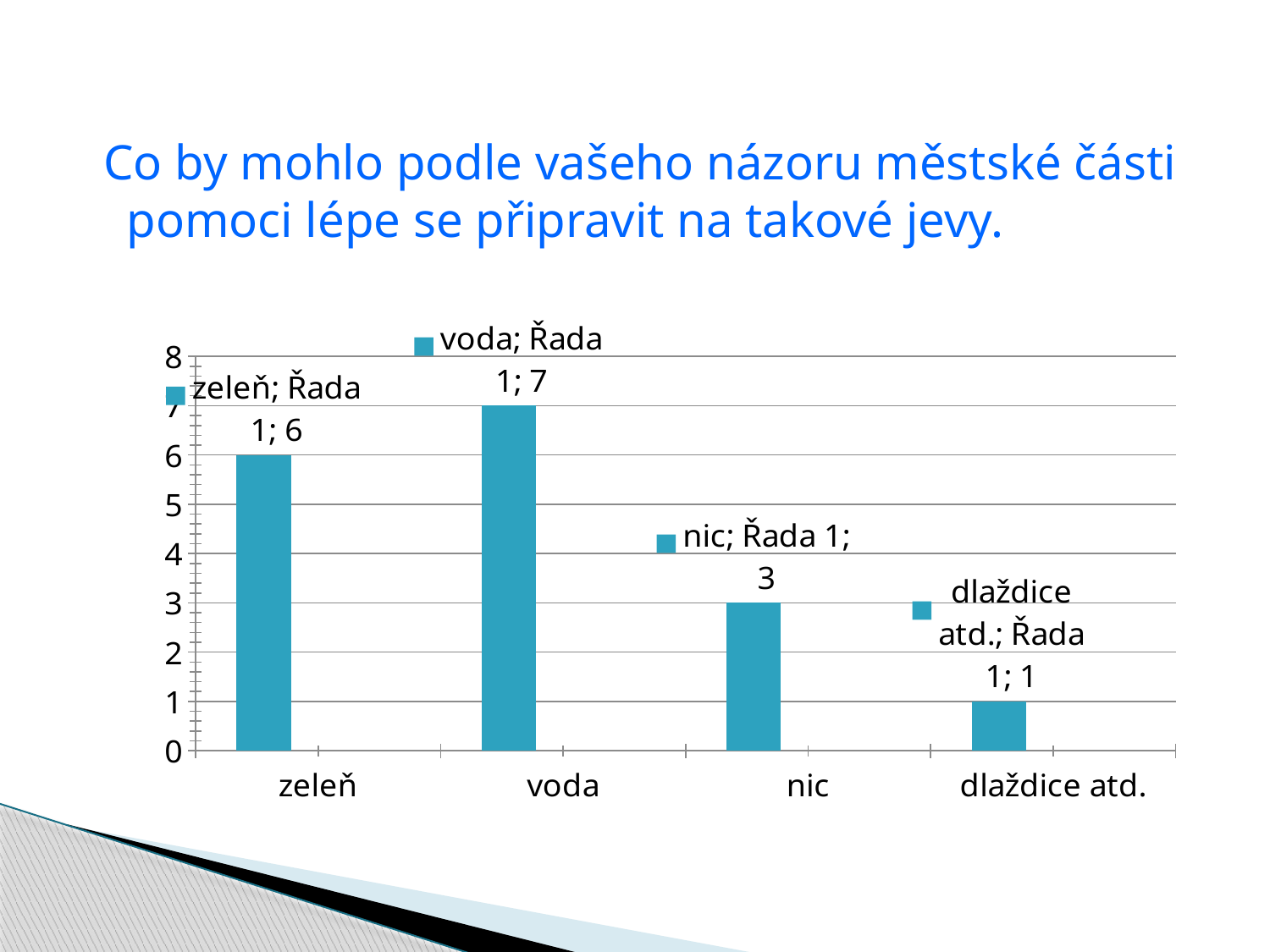
Which category has the lowest value? dlaždice atd. What is the name of the data series shown in the data labels? Řada 1 What is the value for nic? 3 What is the value for voda? 7 What kind of chart is shown on the slide? bar chart Which is larger, the value for zeleň or the value for nic? zeleň Which category has the highest value? voda What is the value for zeleň? 6 What is the difference between the values for zeleň and dlaždice atd.? 5 What is the difference between the values for voda and nic? 4 What is the value for dlaždice atd.? 1 How many categories are shown on the x axis? 4